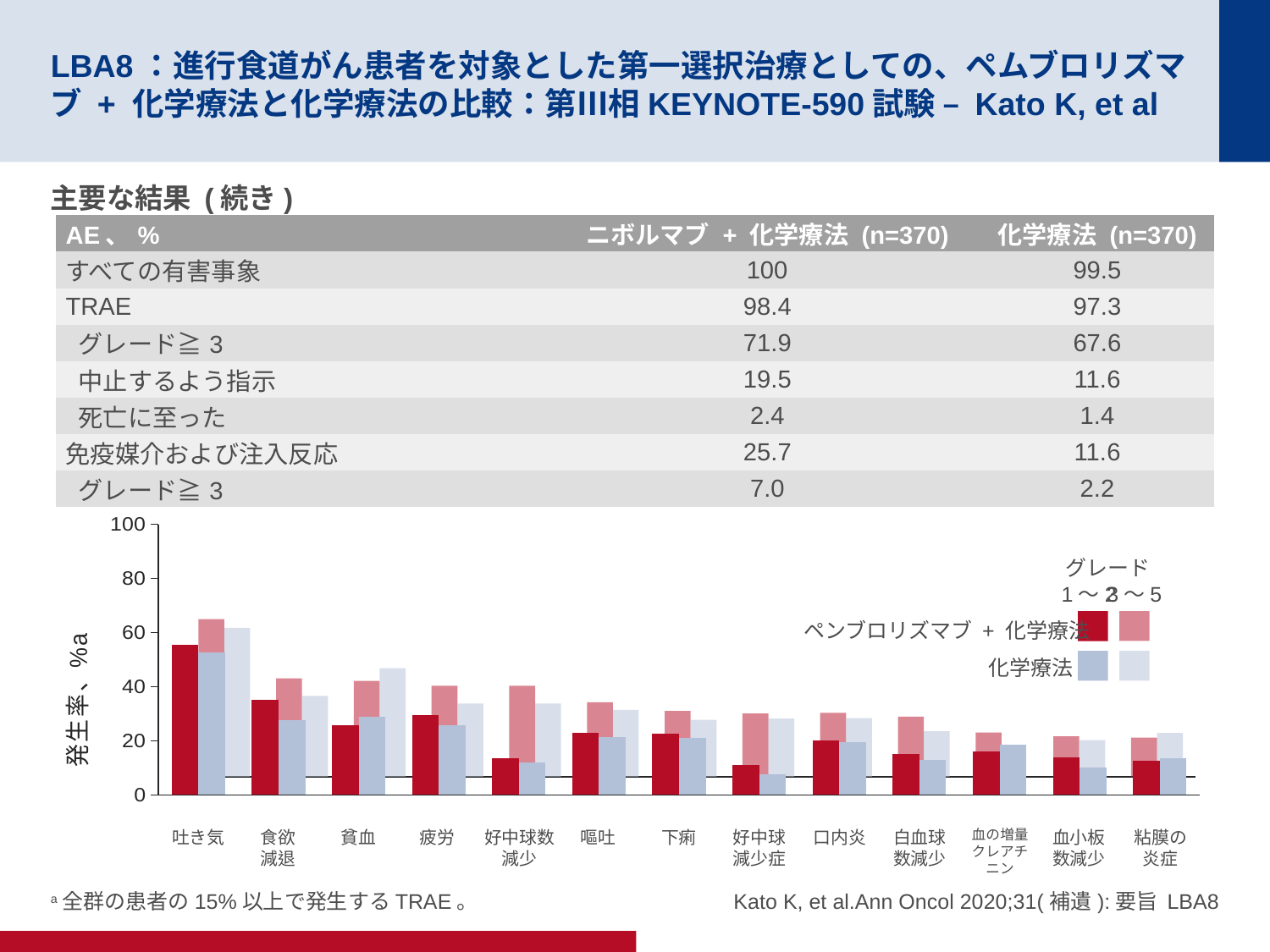
In the bar chart, is the grade 1–2 (dark red) value for 好中球数減少 in the ペンブロリズマブ + 化学療法 group greater or less than 20? less In the bar chart, which has the larger grade 1–2 (dark red) value in the ペンブロリズマブ + 化学療法 group: 食欲減退 or 貧血? 食欲減退 How many treatment groups does the legend of the bar chart list? 2 In the bar chart, is the grade 1–2 (dark red) value for 吐き気 in the ペンブロリズマブ + 化学療法 group greater or less than 40? greater Do the bar heights in the chart generally rise or fall from left to right along the x axis? fall How many adverse event categories are shown along the x axis of the bar chart? 13 What is the label of the y axis of the bar chart? 発生率、% Which adverse event category has the tallest bars in the bar chart? 吐き気 What kind of chart is shown at the bottom of the slide? bar chart In the bar chart, is the grade 1–2 (dark blue) value for 好中球減少症 in the 化学療法 group greater or less than 20? less In the bar chart, which category has higher bars overall: 吐き気 or 粘膜の炎症? 吐き気